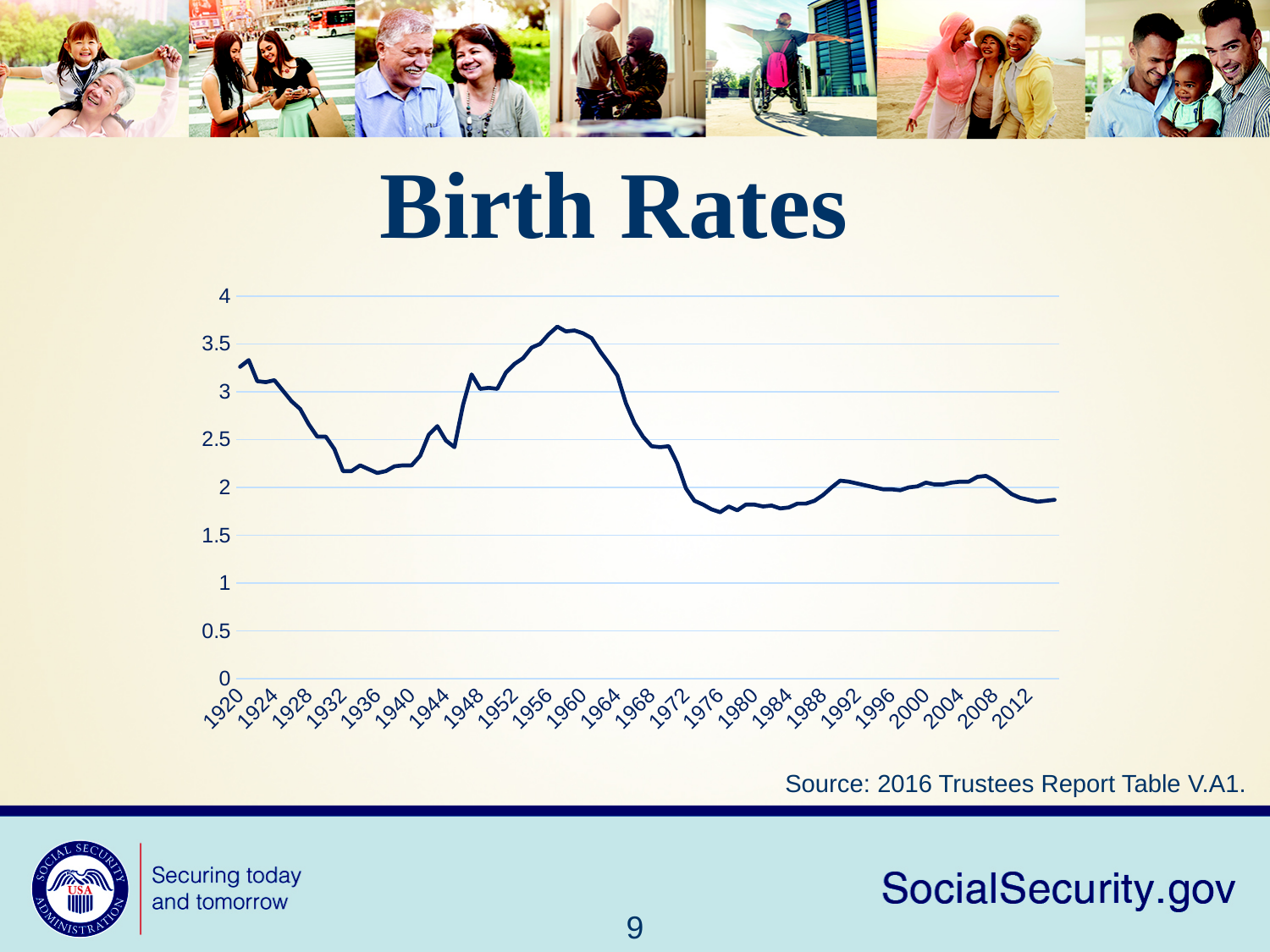
Is the birth rate value for 2012 greater or less than 2? less Is the birth rate value for 1960 greater or less than 3.5? greater What is the title of the chart? Birth Rates Is the birth rate value for 1964 greater or less than 3? greater What kind of chart is shown on the slide? line chart Does the birth rate rise or fall between 1920 and 1936? fall Which year has the highest birth rate on the chart, 1960 or 1980? 1960 Does the birth rate rise or fall between 1960 and 1976? fall What is the source cited for the chart? 2016 Trustees Report Table V.A1.